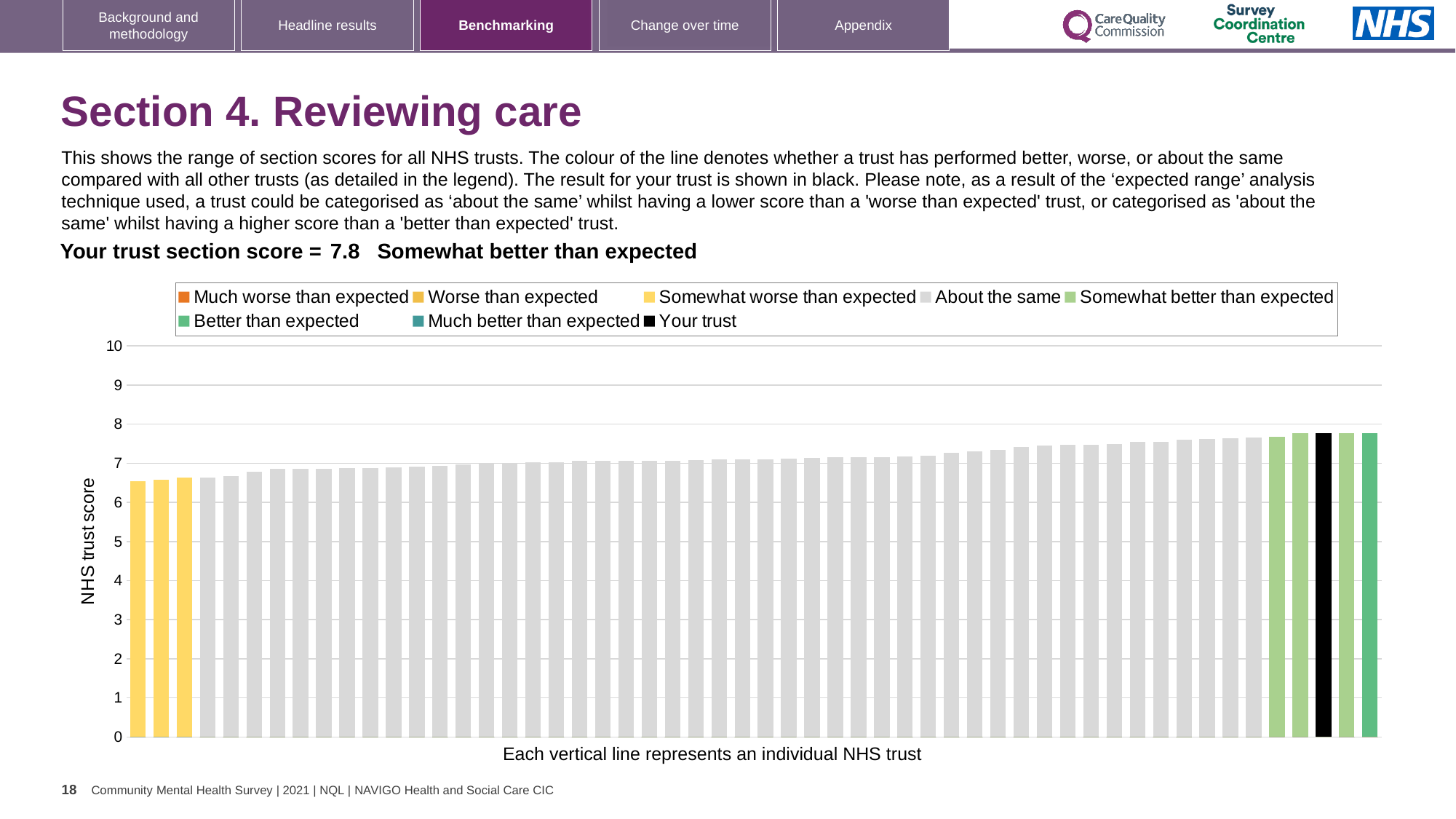
What is the label below the horizontal axis of the chart? Each vertical line represents an individual NHS trust How many entries does the chart legend list? 8 Is the value for your trust (the black bar) greater or less than 7? greater Which performance category is your trust placed in for Section 4? Somewhat better than expected How many bars are coloured yellow (Somewhat worse than expected)? 3 Is the value of the highest bar in the chart greater or less than 8? less What is the section score for your trust shown on the slide? 7.8 Do the bar values rise or fall from left to right along the x axis? rise Is the value of the leftmost bar greater or less than 7? less What is the label on the vertical axis of the chart? NHS trust score What type of chart is shown on the slide? bar chart